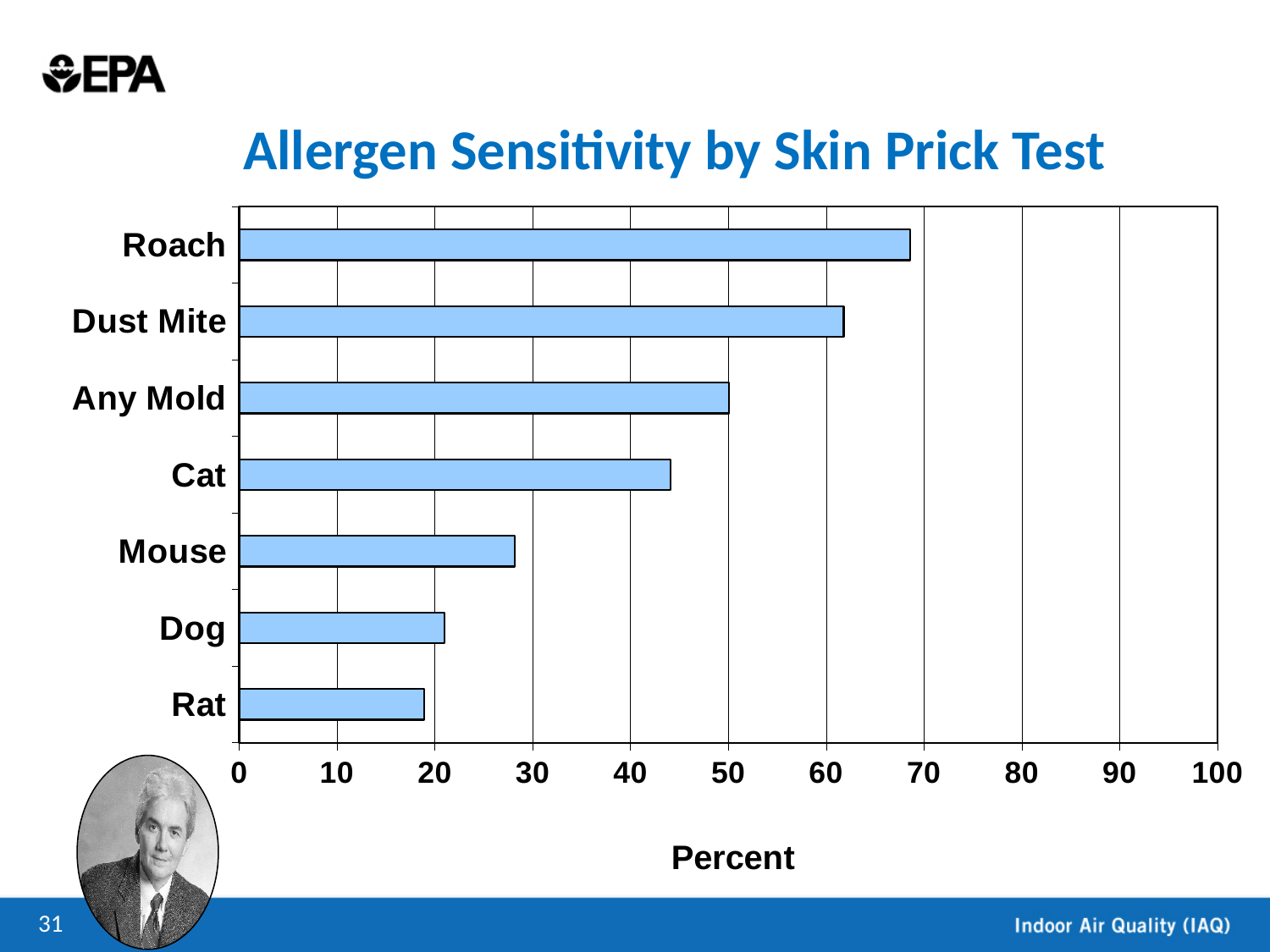
Which has a larger value, Mouse or Cat? Cat How many allergen categories are plotted in the chart? 7 Is the value for Cat greater or less than 40? greater Is the value for Dust Mite greater or less than 70? less What is the label on the horizontal axis of the chart? Percent Is the value for Mouse greater or less than 30? less Which allergen has the highest sensitivity percentage? Roach What kind of chart is shown on the slide? bar chart Which has a larger value, Dust Mite or Any Mold? Dust Mite Which allergen has the lowest sensitivity percentage? Rat What is the title of the chart? Allergen Sensitivity by Skin Prick Test